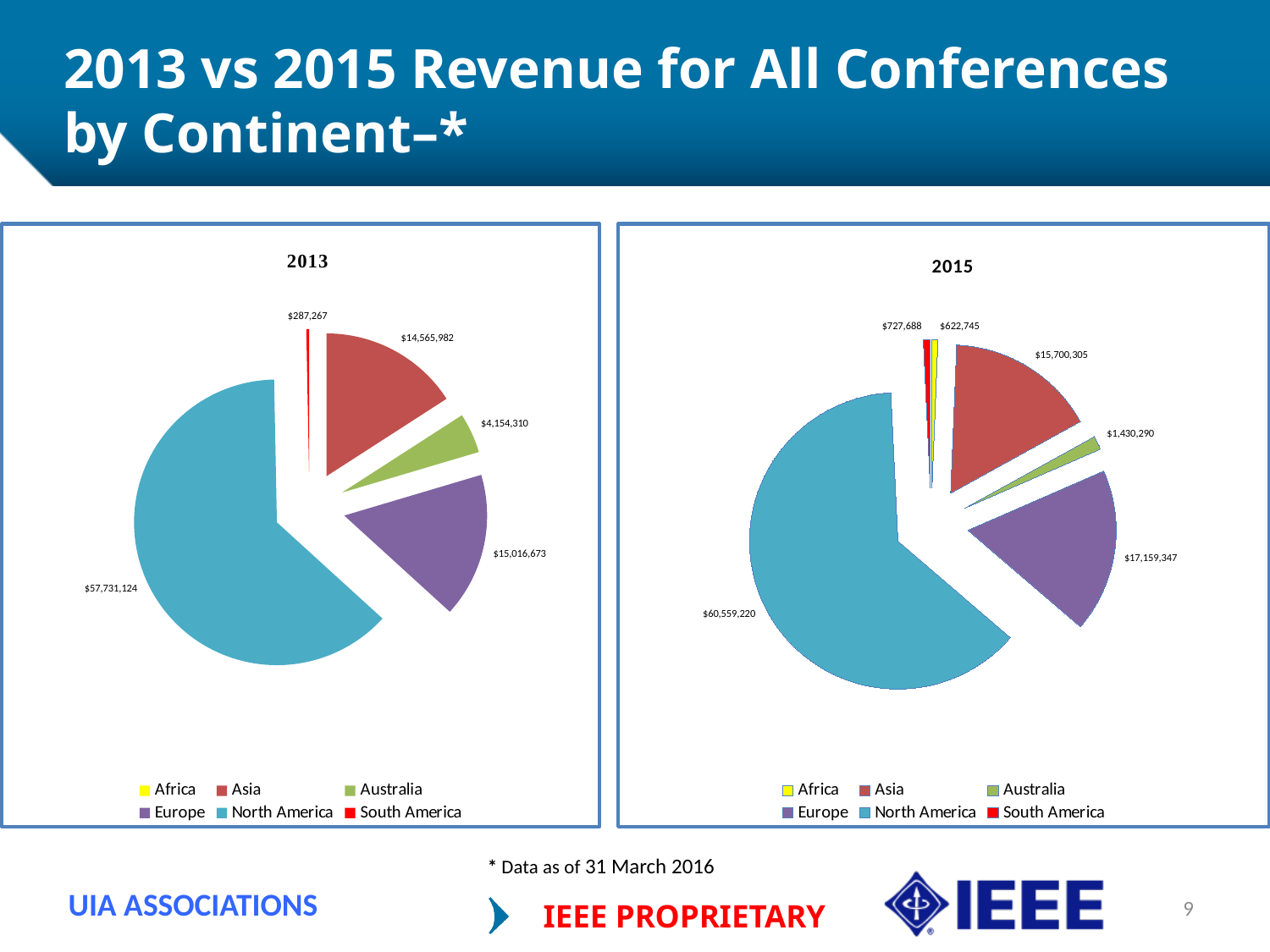
In the 2015 pie chart, what is the revenue for Europe? $17,159,347 How many entries does the legend of the 2013 pie chart list? 6 In the 2015 pie chart, what is the revenue for North America? $60,559,220 In the 2015 pie chart, what is the revenue for Asia? $15,700,305 In the 2013 pie chart, what is the revenue for Asia? $14,565,982 In the 2015 pie chart, what is the difference between the revenue for Europe and the revenue for Asia? $1,459,042 In the 2013 pie chart, what is the revenue for Australia? $4,154,310 In the 2015 pie chart, what is the revenue for Australia? $1,430,290 In the 2015 pie chart, which is larger, the revenue for Europe or for Asia? Europe In the 2013 pie chart, what is the revenue for Europe? $15,016,673 In the 2013 pie chart, which continent has the largest slice? North America In the 2013 pie chart, what is the revenue for North America? $57,731,124